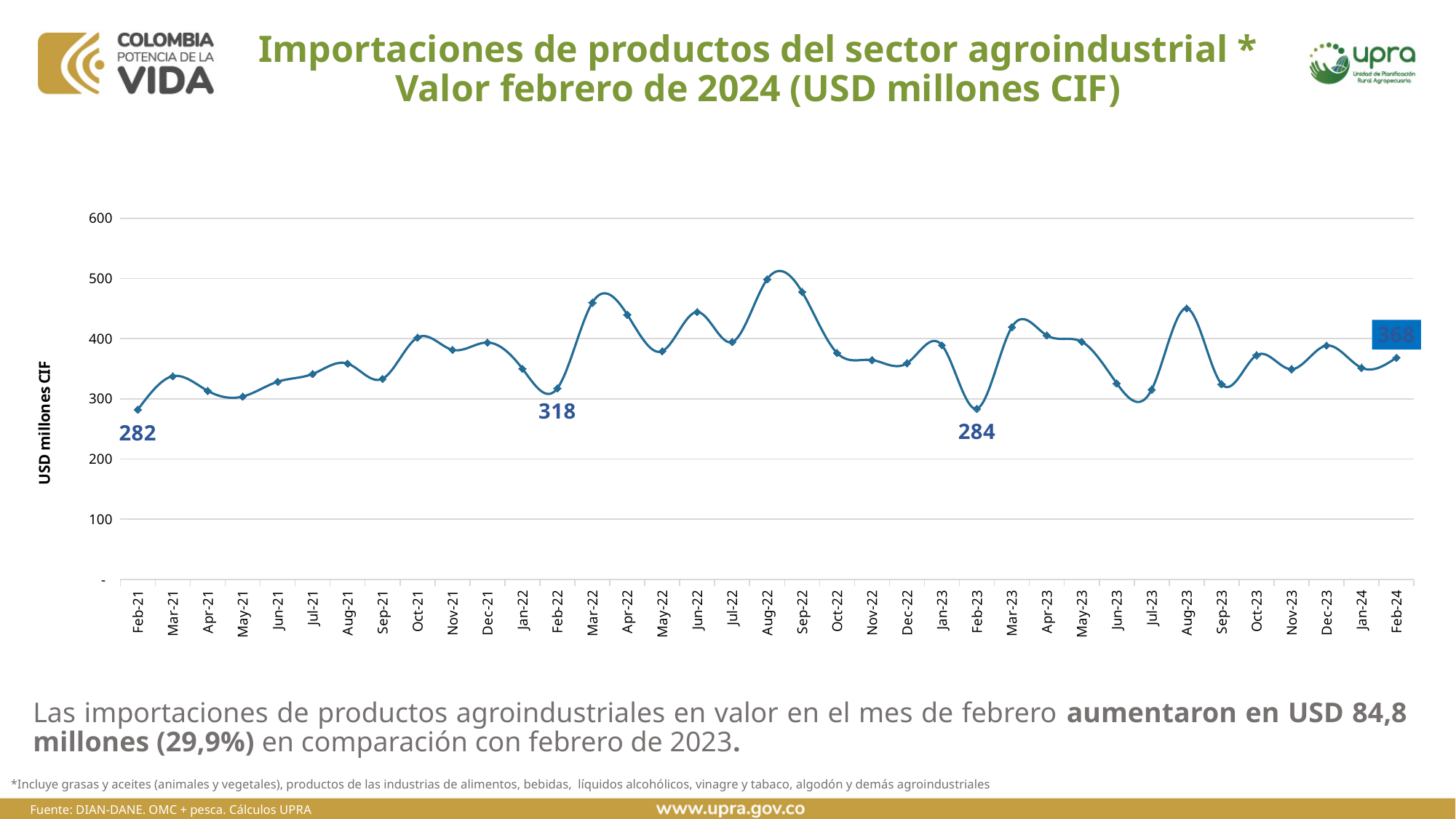
What is the value for Feb-24? 368 Is the value for Jul-23 greater or less than 400? less What is the value for Feb-22? 318 What is the value for Feb-23? 284 Is the value for Aug-22 greater or less than 400? greater What is the label of the vertical axis? USD millones CIF Which month has the highest value on the chart? Aug-22 What is the difference between the values for Feb-24 and Feb-23? 84 Which is larger, the value for Feb-24 or the value for Feb-22? Feb-24 What kind of chart is shown on the slide? line chart What is the value for Feb-21? 282 How many monthly data points are plotted on the chart? 37